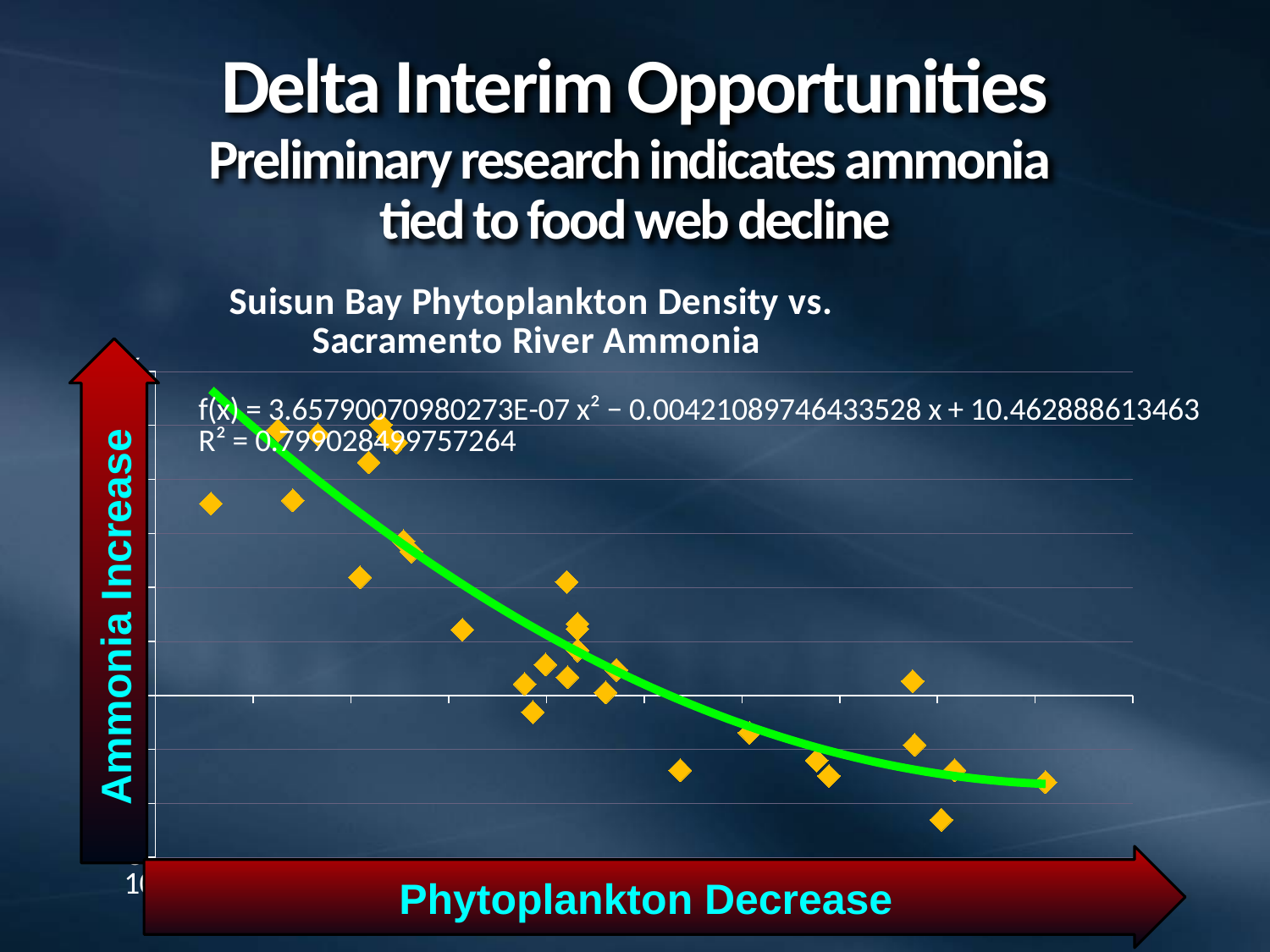
Do the plotted values generally rise or fall from left to right along the x axis? fall What R² value is printed on the chart? 0.799028499757264 What is the title of the chart? Suisun Bay Phytoplankton Density vs. Sacramento River Ammonia What is the constant term in the trendline equation shown on the chart? 10.462888613463 What kind of chart is shown on the slide? scatter chart Does the trendline slope downward or upward as it moves to the right? downward What colour is the fitted trendline on the chart? green What is the trendline equation printed on the chart? f(x) = 3.65790070980273E-07 x² − 0.00421089746433528 x + 10.462888613463